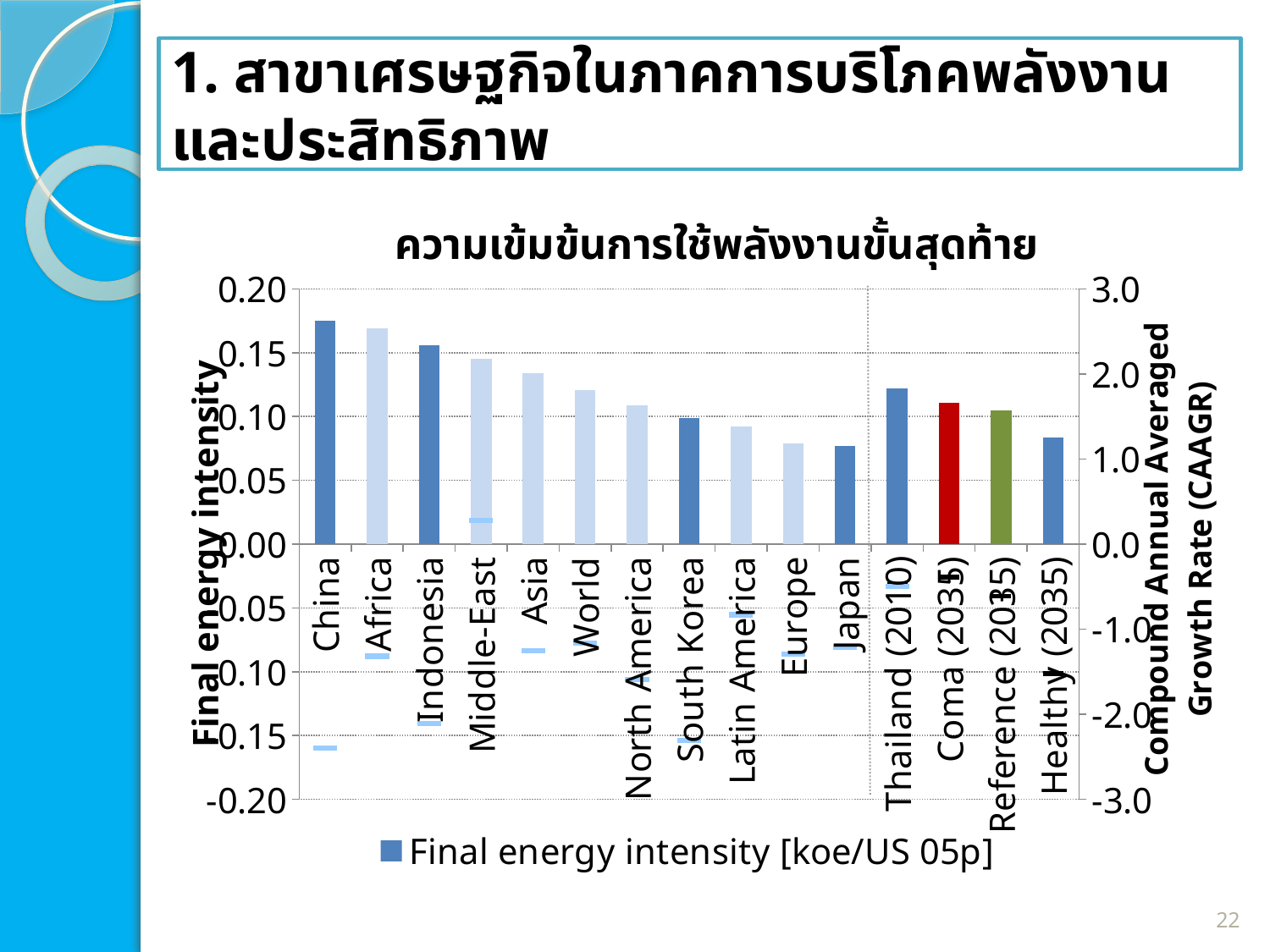
How many categories are shown along the x axis of the chart? 15 What is the legend entry shown below the chart? Final energy intensity [koe/US 05p] Which has the larger final energy intensity, China or Japan? China Do the final energy intensity values rise or fall from China to Japan along the x axis? fall What is the label of the right-hand vertical axis? Compound Annual Averaged Growth Rate (CAAGR) Which has the larger final energy intensity, Thailand (2010) or Healthy (2035)? Thailand (2010) Is the final energy intensity value for Healthy (2035) greater or less than 0.10? less Is the final energy intensity value for China greater or less than 0.15? greater How many series does the chart legend list? 1 Is the final energy intensity value for World greater or less than 0.10? greater What kind of chart is shown on the slide? bar chart